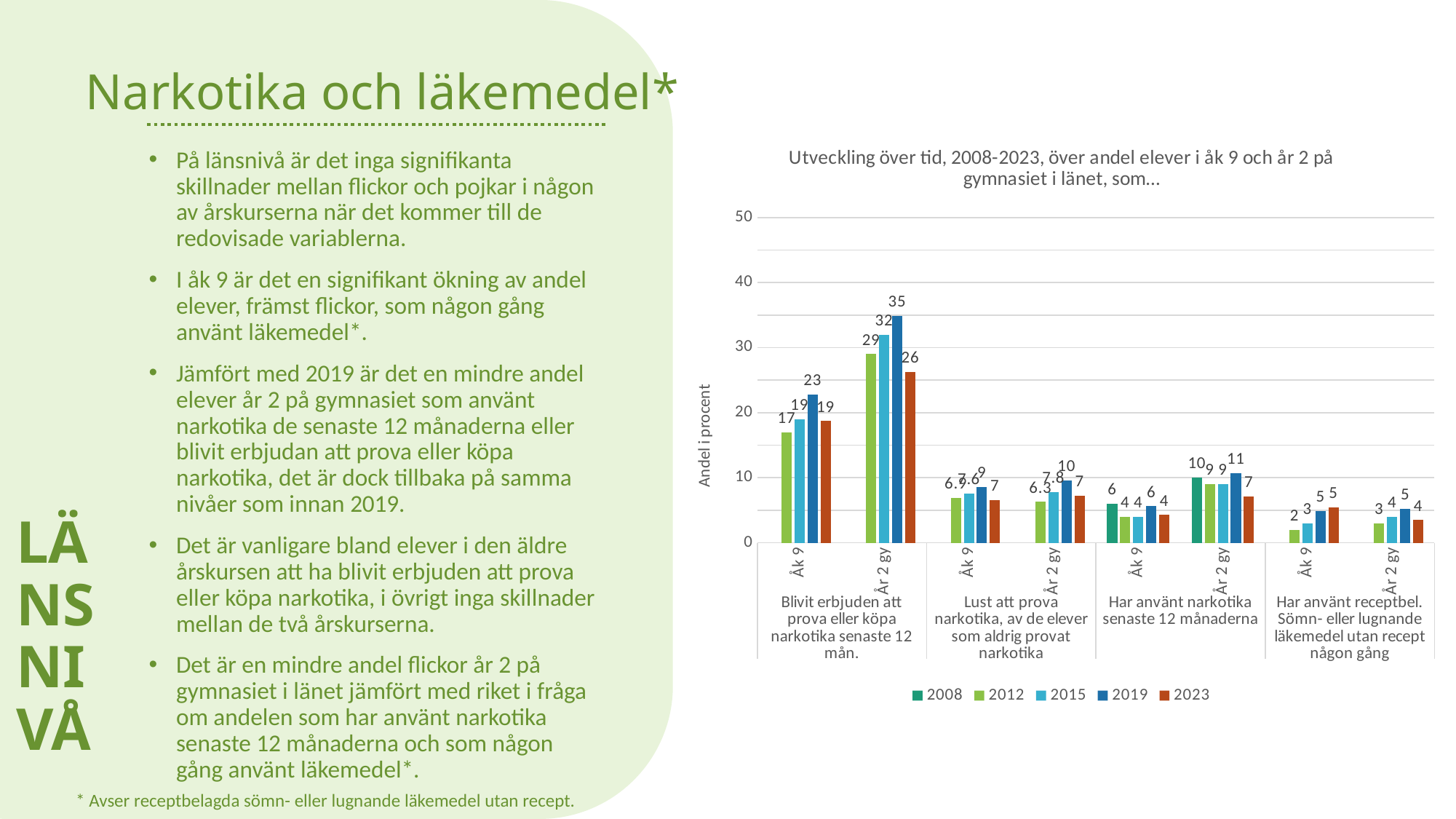
What is the 2012 value for Åk 9 in the group 'Har använt receptbel. Sömn- eller lugnande läkemedel utan recept någon gång'? 2 What is the label of the vertical axis? Andel i procent What is the 2019 value for År 2 gy in the group 'Blivit erbjuden att prova eller köpa narkotika senaste 12 mån.'? 35 How many series does the legend list? 5 What is the 2012 value for Åk 9 in the group 'Blivit erbjuden att prova eller köpa narkotika senaste 12 mån.'? 17 Which year has the highest value for År 2 gy in the group 'Blivit erbjuden att prova eller köpa narkotika senaste 12 mån.'? 2019 What is the 2023 value for År 2 gy in the group 'Har använt narkotika senaste 12 månaderna'? 7 Which is larger in the group 'Har använt narkotika senaste 12 månaderna': the 2008 value for Åk 9 or the 2008 value for År 2 gy? År 2 gy Which year has the lowest value for År 2 gy in the group 'Har använt narkotika senaste 12 månaderna'? 2023 What kind of chart is shown on the slide? Bar chart What is the difference between the 2019 and 2023 values for År 2 gy in the group 'Blivit erbjuden att prova eller köpa narkotika senaste 12 mån.'? 9 What is the 2019 value for År 2 gy in the group 'Lust att prova narkotika, av de elever som aldrig provat narkotika'? 10